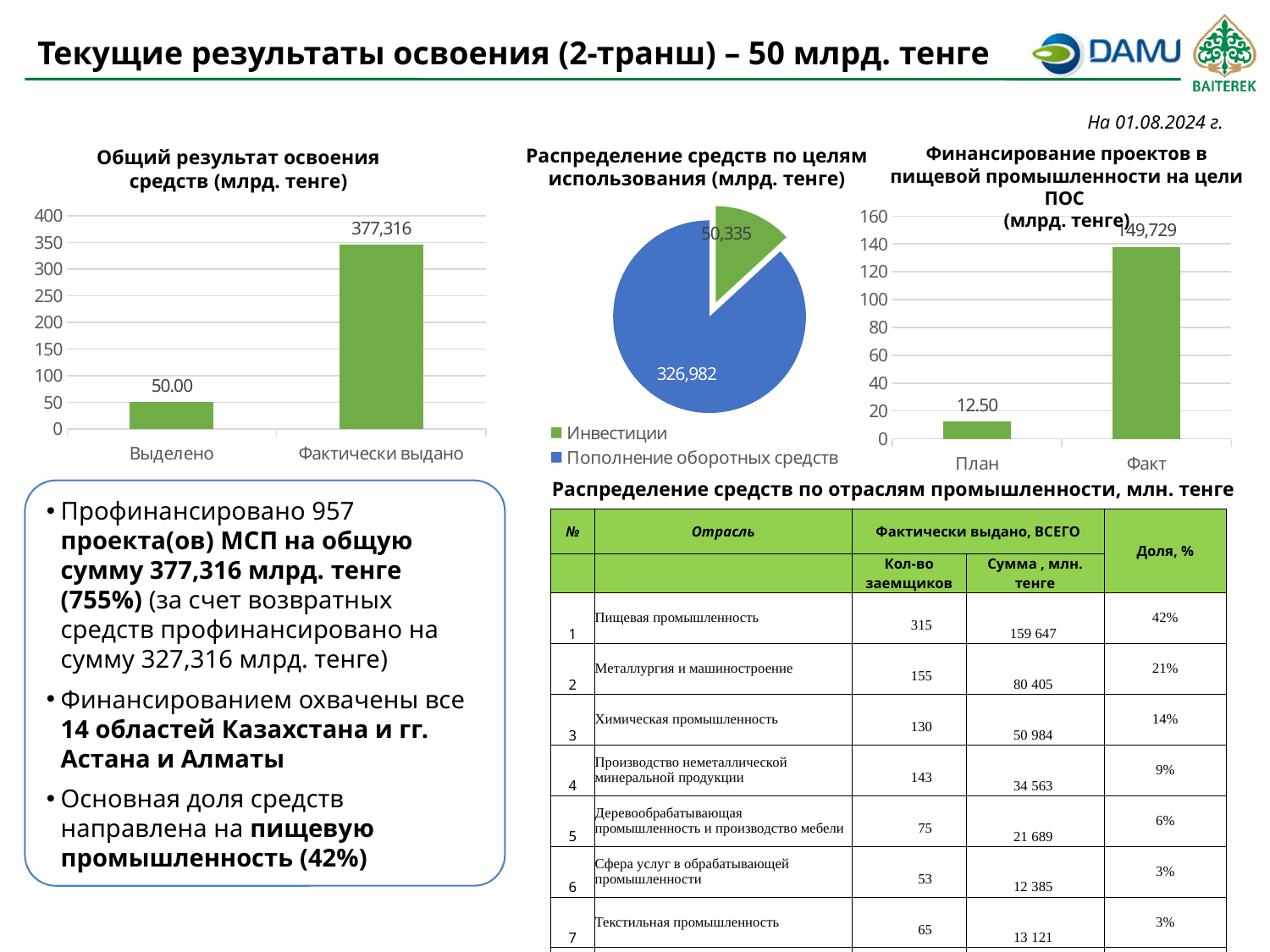
In the chart 'Общий результат освоения средств (млрд. тенге)', which category has the higher value? Фактически выдано In the pie chart 'Распределение средств по целям использования (млрд. тенге)', which slice is the largest? Пополнение оборотных средств In the chart 'Финансирование проектов в пищевой промышленности на цели ПОС (млрд. тенге)', what is the value for 'Факт'? 149,729 In the chart 'Общий результат освоения средств (млрд. тенге)', what is the value for 'Фактически выдано'? 377,316 In the chart 'Общий результат освоения средств (млрд. тенге)', is the value for 'Выделено' greater or less than 100? less What kind of chart is 'Общий результат освоения средств (млрд. тенге)'? bar chart In the pie chart 'Распределение средств по целям использования (млрд. тенге)', what is the value for 'Инвестиции'? 50,335 In the chart 'Общий результат освоения средств (млрд. тенге)', what is the value for 'Выделено'? 50.00 In the pie chart 'Распределение средств по целям использования (млрд. тенге)', what is the value for 'Пополнение оборотных средств'? 326,982 How many entries does the legend of the pie chart 'Распределение средств по целям использования (млрд. тенге)' list? 2 In the chart 'Финансирование проектов в пищевой промышленности на цели ПОС (млрд. тенге)', what is the value for 'План'? 12.50